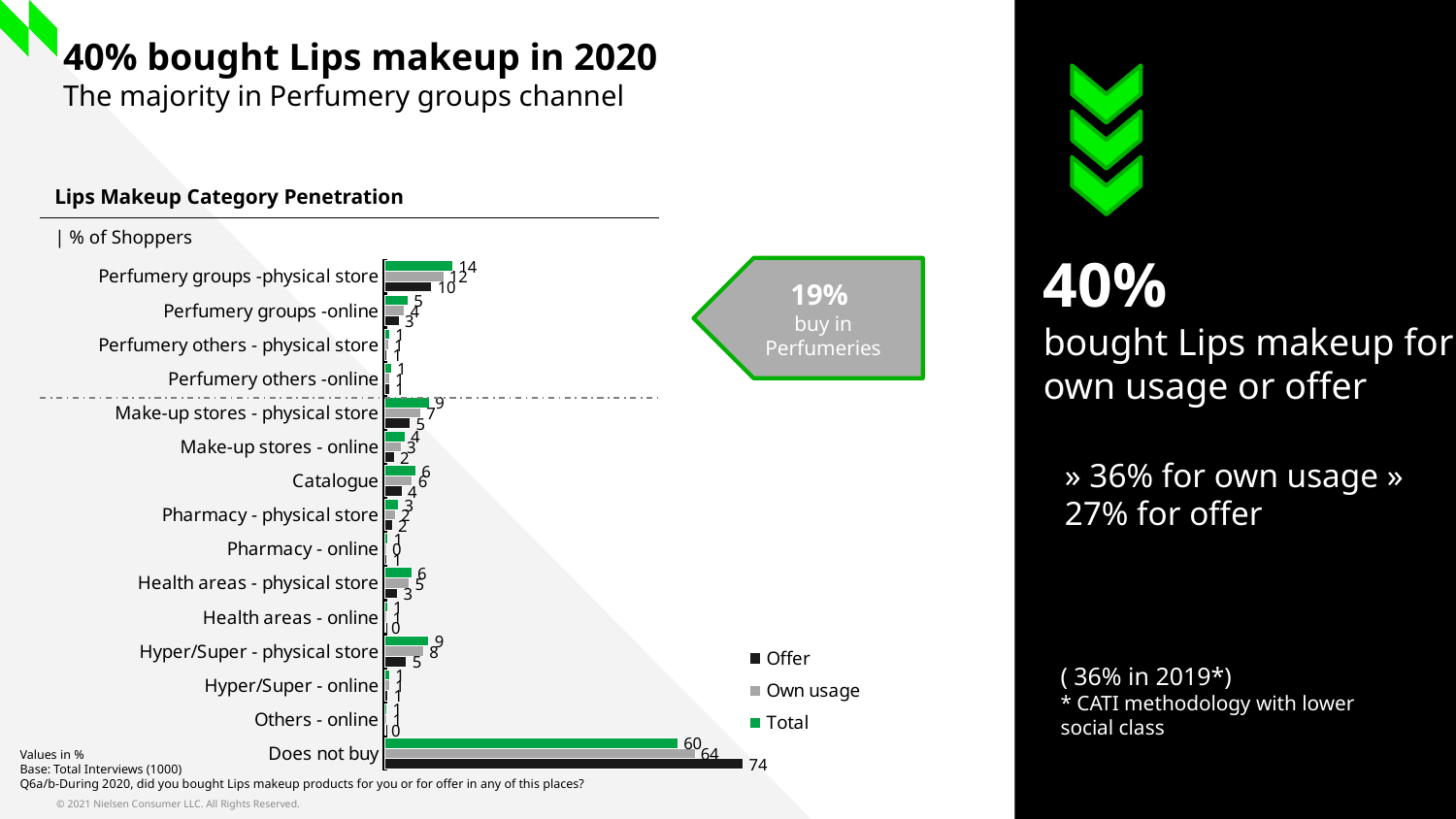
What is the difference between the Own usage and Offer values for Perfumery groups - physical store? 2 Excluding Does not buy, which category has the highest Total value? Perfumery groups - physical store Which is larger for Does not buy: the Own usage value or the Total value? Own usage How many categories are shown on the chart? 15 Which series is shown in green in the legend? Total What is the Total value for Perfumery groups - physical store? 14 What is the Own usage value for Hyper/Super - physical store? 8 How many series does the legend list? 3 What kind of chart is shown on the slide? Bar chart What is the Offer value for Does not buy? 74 What is the Total value for Make-up stores - physical store? 9 What is the difference between the Offer and Total values for Does not buy? 14